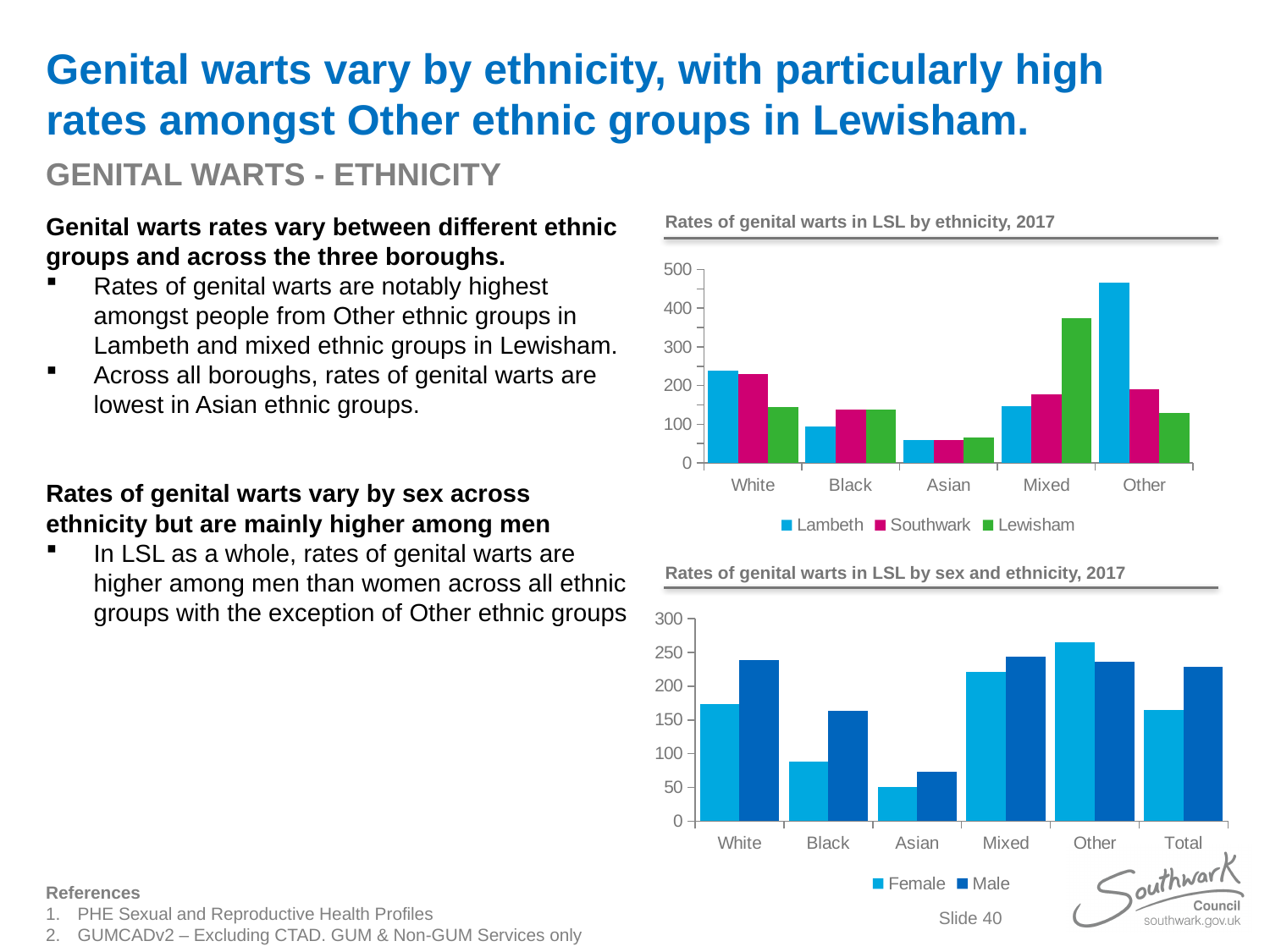
How many categories are shown on the x axis of the chart 'Rates of genital warts in LSL by sex and ethnicity, 2017'? 6 How many series does the legend list in the chart 'Rates of genital warts in LSL by ethnicity, 2017'? 3 In the chart 'Rates of genital warts in LSL by ethnicity, 2017', is the Lambeth value for Other greater or less than 400? greater In the chart 'Rates of genital warts in LSL by sex and ethnicity, 2017', is the Male value for White greater or less than 200? greater What kind of chart is 'Rates of genital warts in LSL by sex and ethnicity, 2017'? bar chart In the chart 'Rates of genital warts in LSL by ethnicity, 2017', which ethnic group has the highest rate for Lambeth? Other In the chart 'Rates of genital warts in LSL by ethnicity, 2017', which ethnic group has the highest rate for Lewisham? Mixed In the chart 'Rates of genital warts in LSL by ethnicity, 2017', is the Lewisham value for Mixed greater or less than 300? greater In the chart 'Rates of genital warts in LSL by sex and ethnicity, 2017', which ethnic group has a higher Female rate than Male rate? Other In the chart 'Rates of genital warts in LSL by sex and ethnicity, 2017', which category has the lowest Female rate? Asian In the chart 'Rates of genital warts in LSL by ethnicity, 2017', which is larger for the White group: Lambeth or Lewisham? Lambeth How many ethnic group categories are shown on the x axis of the chart 'Rates of genital warts in LSL by ethnicity, 2017'? 5